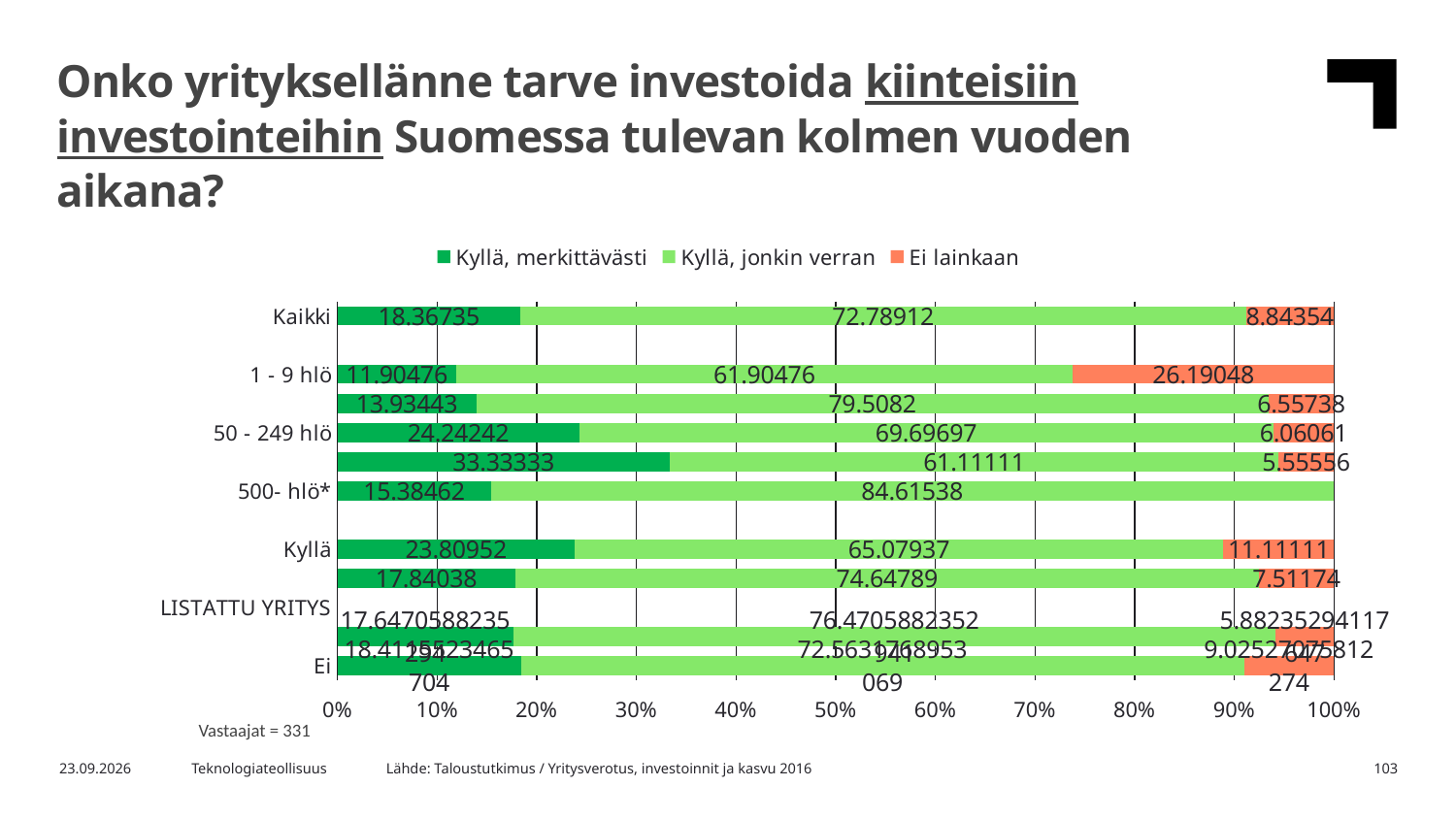
What is the value of "Kyllä, jonkin verran" for the category 500- hlö*? 84.61538 Which category has the highest "Kyllä, jonkin verran" value? 500- hlö* What is the value of "Kyllä, merkittävästi" for the category Kaikki? 18.36735 What is the first entry in the chart legend? Kyllä, merkittävästi What is the value of "Kyllä, merkittävästi" for the category 50 - 249 hlö? 24.24242 How many series does the legend list? 3 What kind of chart is shown on the slide? Stacked bar chart Which has the larger "Ei lainkaan" value, Kaikki or 1 - 9 hlö? 1 - 9 hlö For the category Kaikki, what is the difference between the "Kyllä, jonkin verran" value and the "Kyllä, merkittävästi" value? 54.42177 What is the value of "Ei lainkaan" for the category 1 - 9 hlö? 26.19048 Which category has the highest "Ei lainkaan" value? 1 - 9 hlö What is the value of "Ei lainkaan" for the category Kyllä? 11.11111